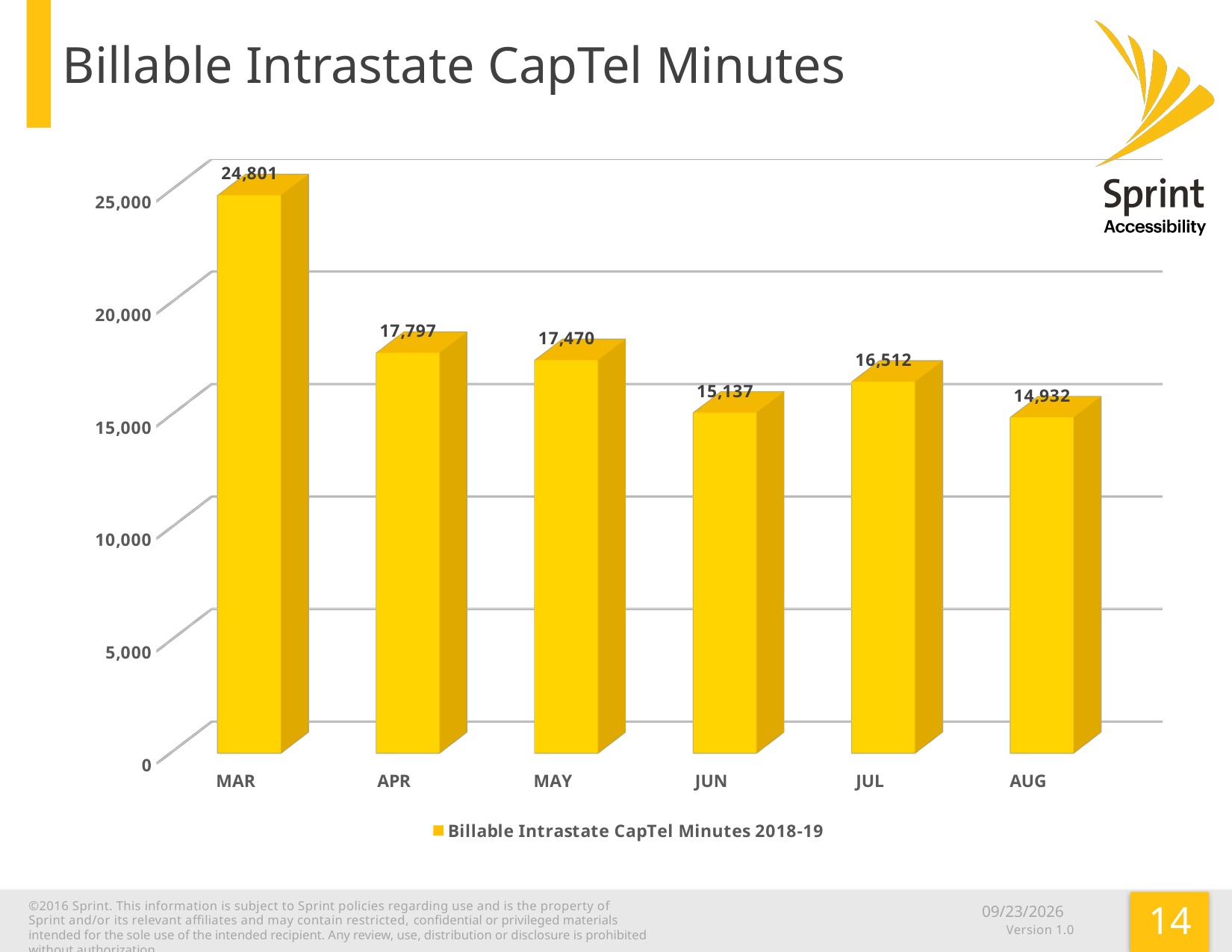
Which month has the highest value? MAR What is the value for JUN? 15,137 What is the legend entry for the series? Billable Intrastate CapTel Minutes 2018-19 What is the value for MAR? 24,801 What is the value for AUG? 14,932 Which is larger, the value for APR or the value for MAY? APR What is the difference between the values for JUL and JUN? 1,375 How many months are shown on the x axis? 6 Which month has the lowest value? AUG Is the value for JUL greater or less than 15,000? greater What is the difference between the values for MAR and APR? 7,004 What kind of chart is shown on the slide? bar chart